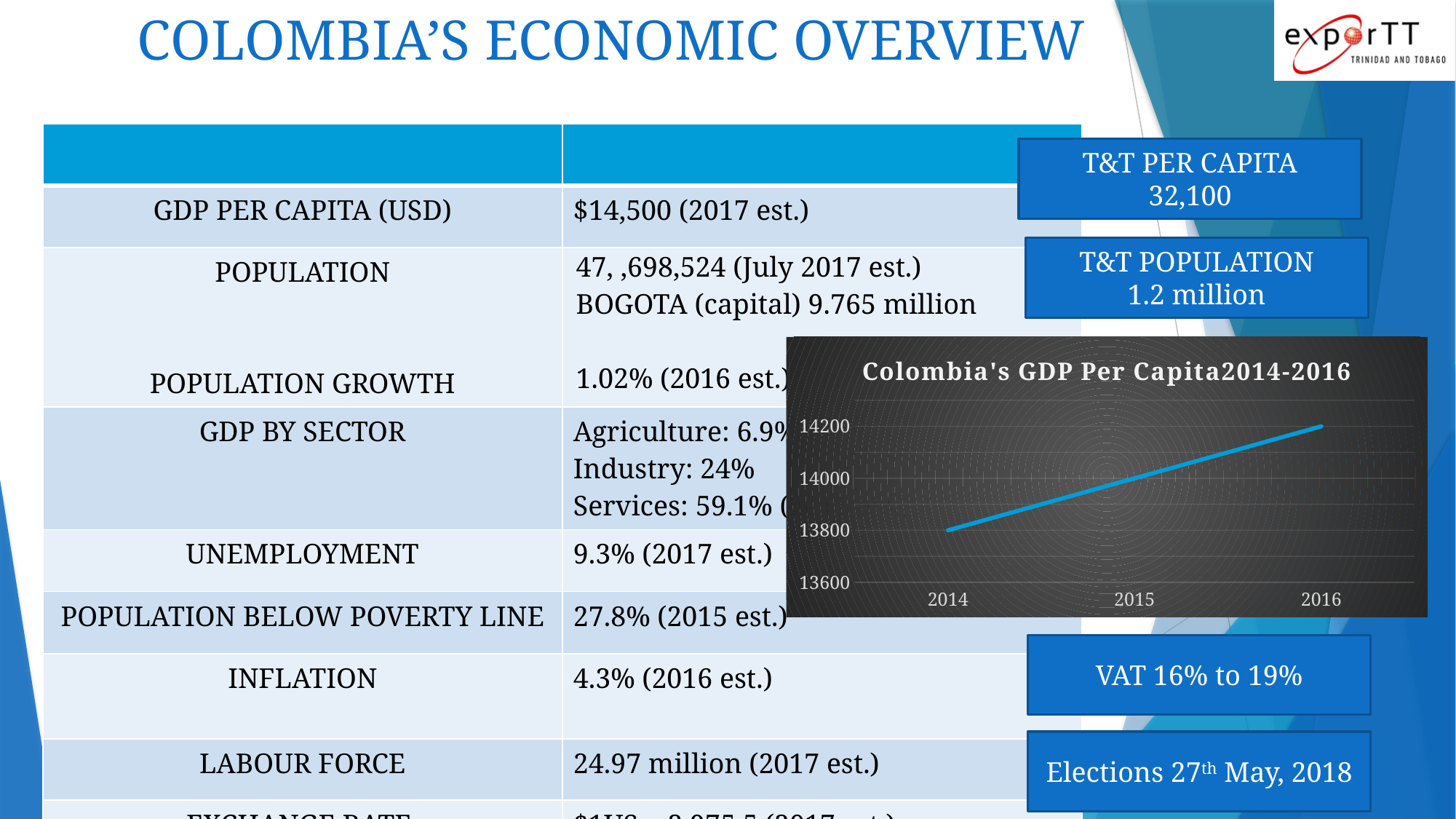
What kind of chart is shown on the slide? line chart Is the value for 2016 greater or less than 14000? greater What is the title of the chart? Colombia's GDP Per Capita2014-2016 Which year has the lowest GDP per capita in the chart? 2014 Is the value for 2014 greater or less than 13600? greater Which year has a larger value in the chart, 2014 or 2016? 2016 Is the value for 2014 greater or less than 14000? less How many years are plotted on the x axis of the chart? 3 What is the lowest tick value shown on the y axis of the chart? 13600 Do the values in the chart rise or fall from 2014 to 2016? rise Which year has the highest GDP per capita in the chart? 2016